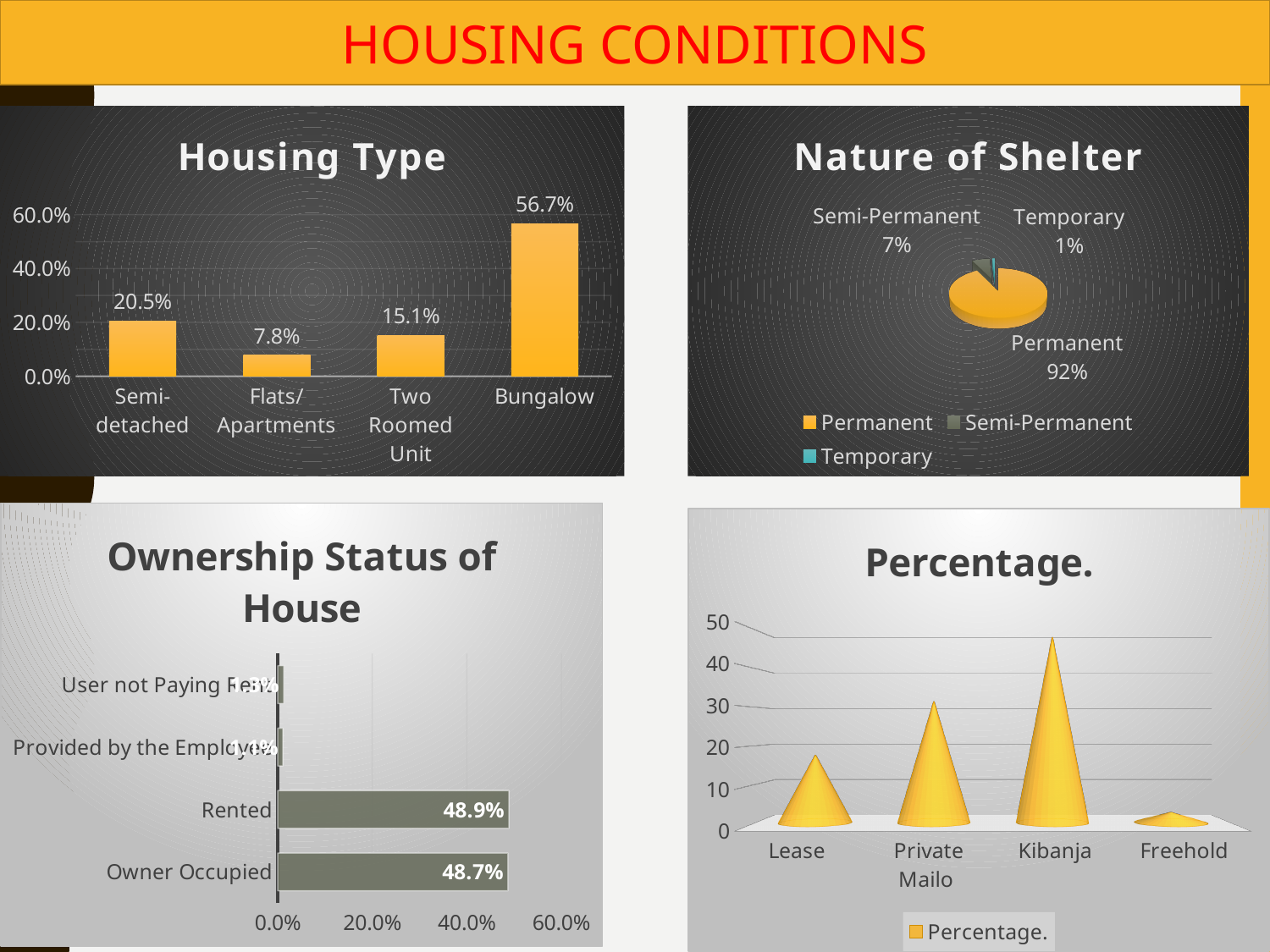
In the Housing Type chart, what is the difference between Semi-detached and Two Roomed Unit? 5.4% In the Ownership Status of House chart, what is the difference between Rented and Owner Occupied? 0.2% In the Percentage. chart, which category has the highest value? Kibanja In the Ownership Status of House chart, what is the value for Rented? 48.9% In the Nature of Shelter chart, what share of the pie is Permanent? 92% In the Percentage. chart, is the value for Freehold greater or less than 10? less In the Percentage. chart, is the value for Kibanja greater or less than 40? greater In the Nature of Shelter chart, which category is the smallest? Temporary In the Housing Type chart, how many housing types are shown? 4 In the Housing Type chart, which housing type has the lowest value? Flats/Apartments In the Housing Type chart, what is the value for Bungalow? 56.7% What kind of chart is the Nature of Shelter chart? Pie chart